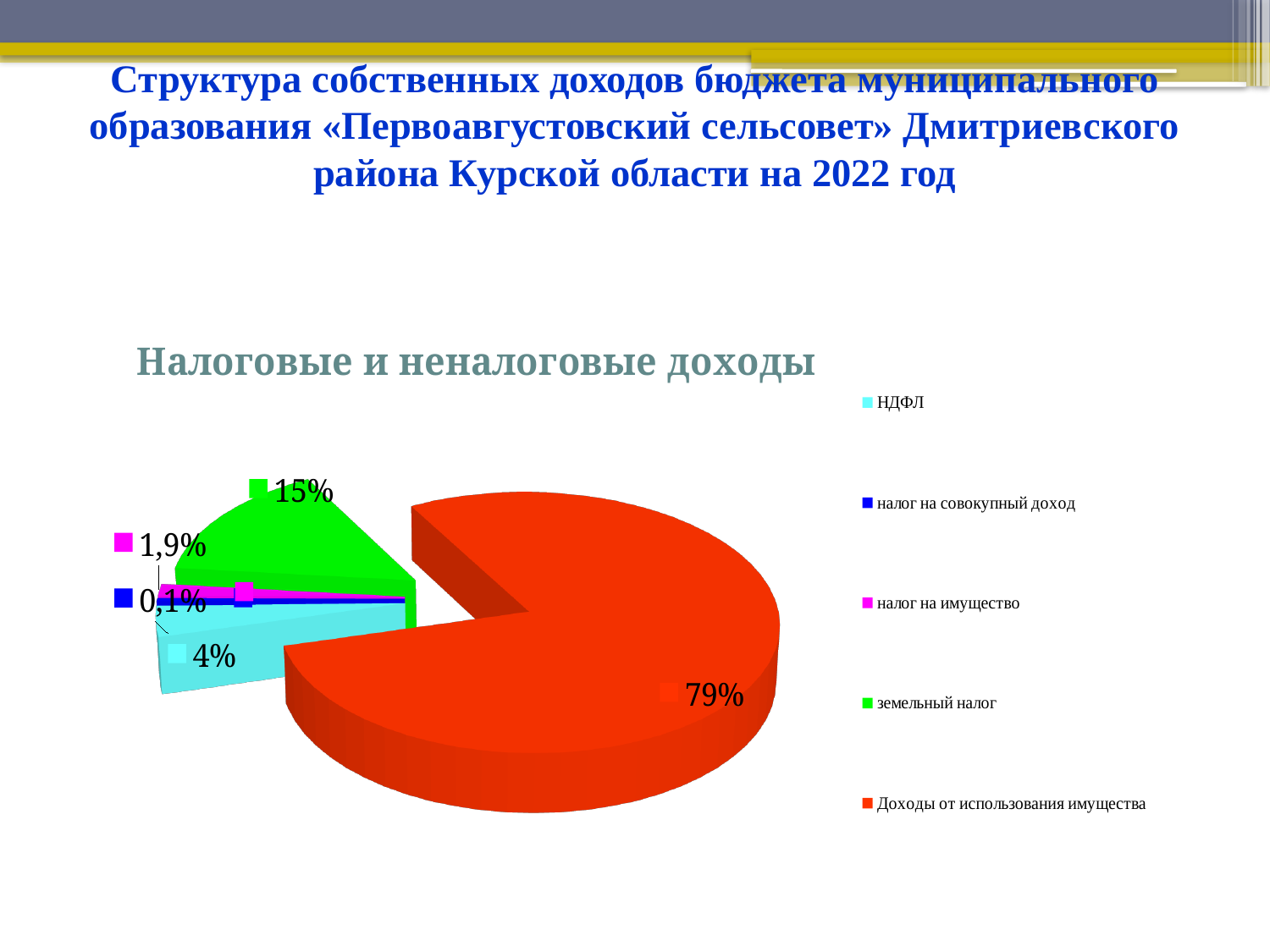
Which category has the smallest share of the pie? налог на совокупный доход What share of the pie does земельный налог have? 15% What share of the pie does НДФЛ have? 4% What share of the pie does налог на совокупный доход have? 0,1% What is the title of the chart? Налоговые и неналоговые доходы Which category has the largest share of the pie? Доходы от использования имущества Which is larger, the share for земельный налог or the share for НДФЛ? земельный налог What kind of chart is shown on the slide? pie chart What colour is the slice for земельный налог? green How many categories does the legend of the pie chart list? 5